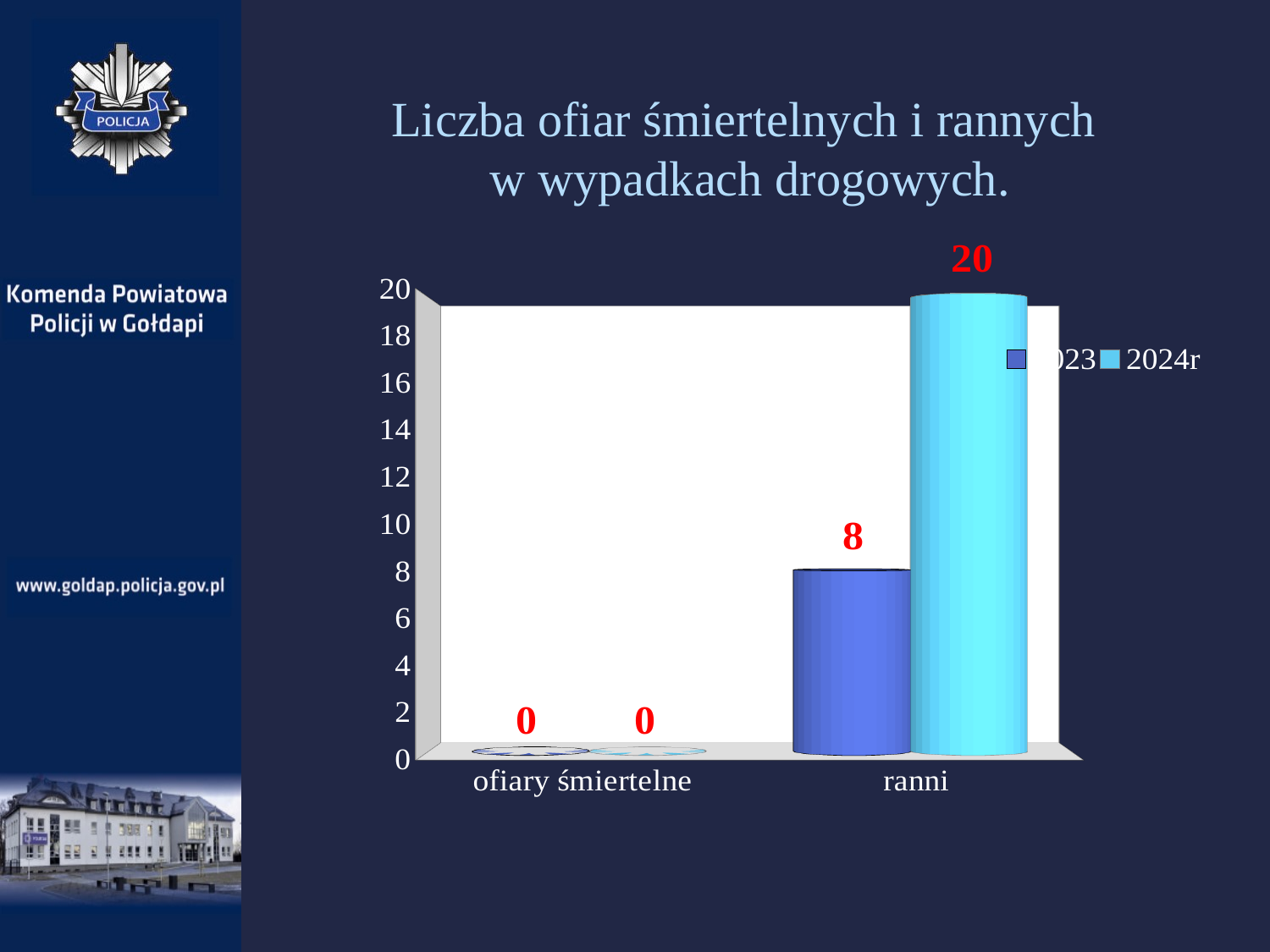
How many series does the legend list? 2 Which category has the highest value on the chart? ranni What is the value for ranni in the darker blue (2023) series? 8 What is the difference between the 2024r and 2023 values for ranni? 12 For ranni, which series has the larger value, 2023 or 2024r? 2024r What is the value for ranni in the 2024r series? 20 What is the value for ofiary śmiertelne in the 2024r series? 0 What kind of chart is shown on the slide? bar chart Which category has the lowest values on the chart? ofiary śmiertelne Is the 2024r value for ranni greater or less than 10? greater How many categories are shown on the x axis? 2 What is the title of the chart? Liczba ofiar śmiertelnych i rannych w wypadkach drogowych.